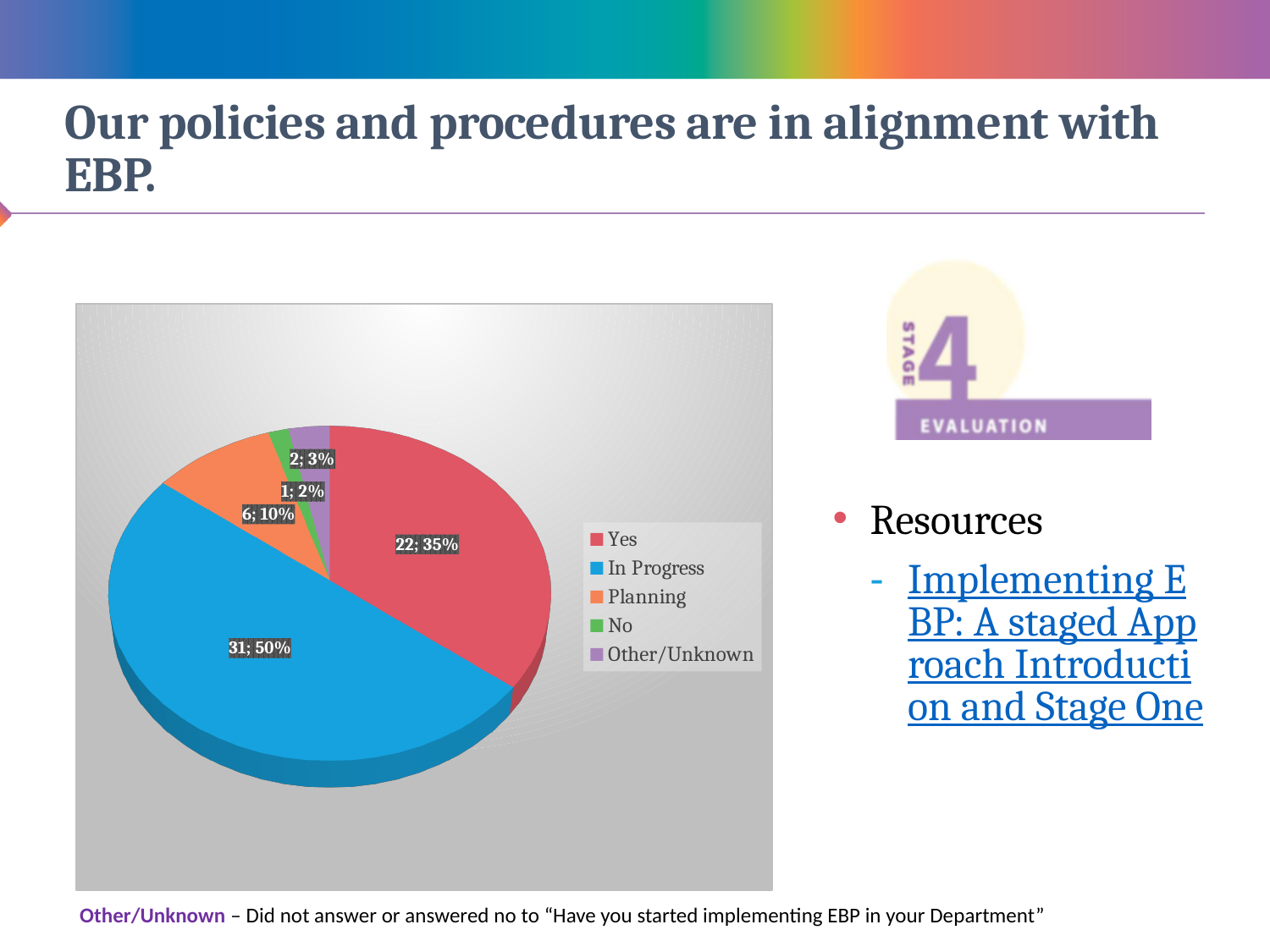
What is the difference in count between "In Progress" and "Yes"? 9 What is the count for the "In Progress" slice of the pie chart? 31 What is the count for the "Planning" slice? 6 Which category has the smallest slice of the pie? No Which is larger, the "Planning" slice or the "Other/Unknown" slice? Planning What percentage of the pie does the "No" slice represent? 2% What kind of chart is shown on the slide? pie chart How many categories does the pie chart show? 5 What percentage of the pie does the "Yes" slice represent? 35% What colour is the "In Progress" slice in the pie chart? blue What percentage of the pie does the "Other/Unknown" slice represent? 3% Which category has the largest slice of the pie? In Progress